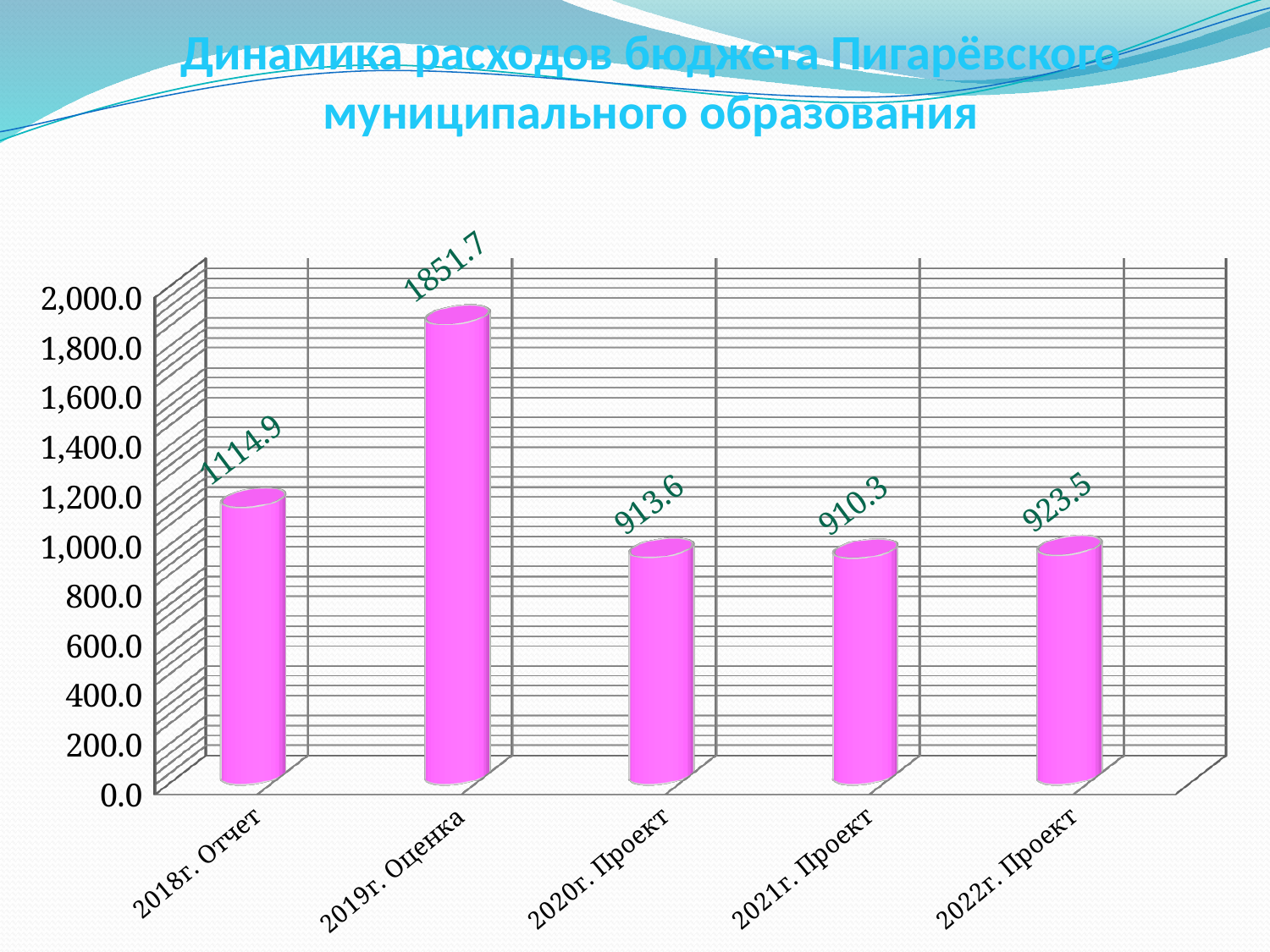
What is the difference between the values for 2019г. Оценка and 2018г. Отчет? 736.8 Which category has the lowest value? 2021г. Проект What is the value for 2019г. Оценка? 1851.7 What kind of chart is shown on the slide? Bar chart What is the title of the chart? Динамика расходов бюджета Пигарёвского муниципального образования What is the value for 2021г. Проект? 910.3 Which category has the highest value? 2019г. Оценка Which is larger, the value for 2018г. Отчет or the value for 2020г. Проект? 2018г. Отчет What is the difference between the values for 2022г. Проект and 2020г. Проект? 9.9 How many categories are shown on the x axis? 5 What is the value for 2018г. Отчет? 1114.9 What is the value for 2022г. Проект? 923.5